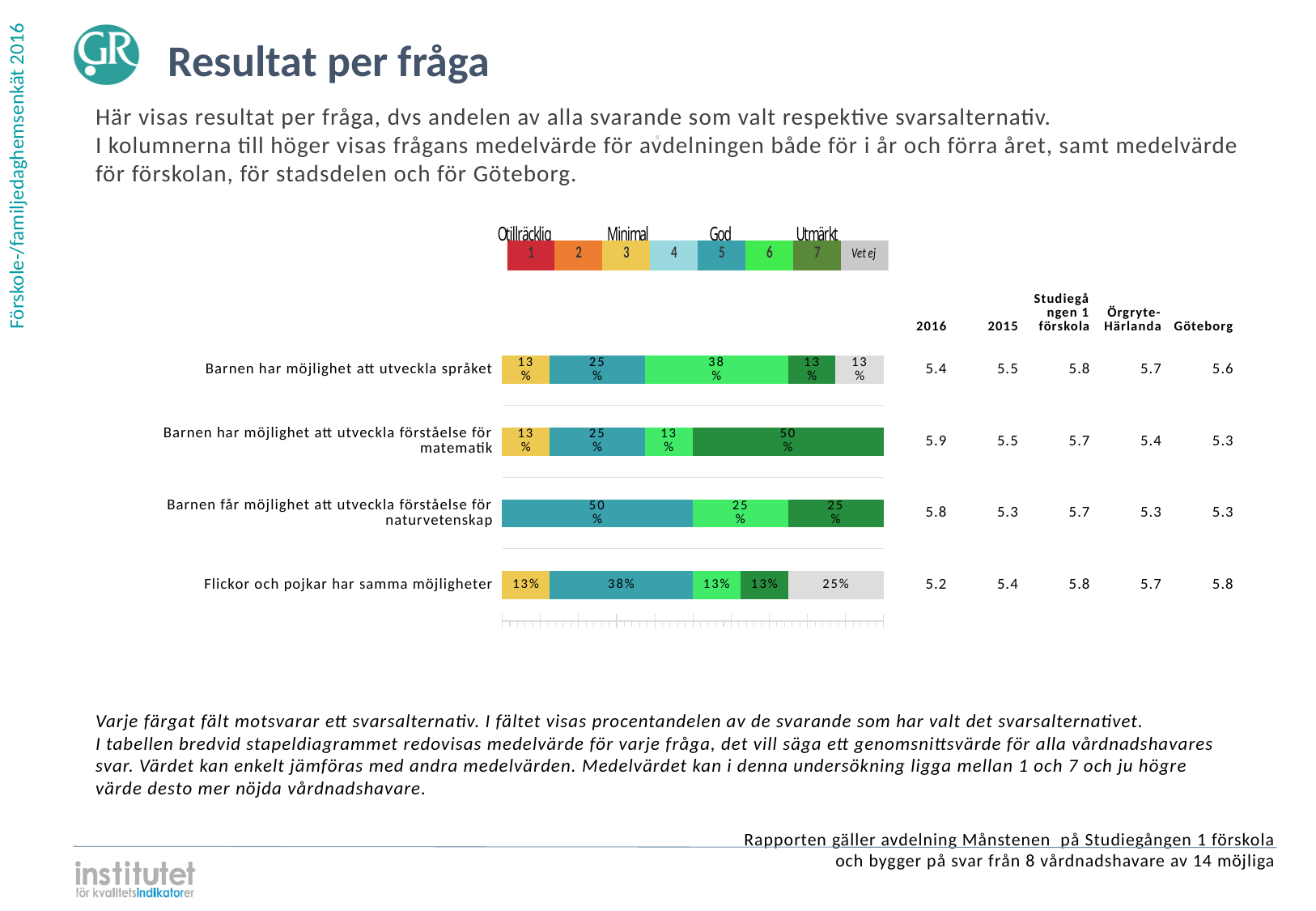
Which is larger for 'Flickor och pojkar har samma möjligheter': the share for option 5 or the share for 'Vet ej'? Option 5 What is the combined share of options 6 and 7 for 'Barnen får möjlighet att utveckla förståelse för naturvetenskap'? 50% How many response options does the legend above the chart list? 8 What label does the legend give to response option 7? Utmärkt What percentage of respondents chose option 7 for 'Barnen har möjlighet att utveckla förståelse för matematik'? 50% What percentage of respondents answered 'Vet ej' for 'Flickor och pojkar har samma möjligheter'? 25% What kind of chart is shown on the slide? Stacked bar chart What is the difference between the option 7 share for 'Barnen har möjlighet att utveckla förståelse för matematik' and the option 7 share for 'Barnen har möjlighet att utveckla språket'? 37 percentage points What percentage of respondents chose option 5 for 'Barnen får möjlighet att utveckla förståelse för naturvetenskap'? 50% How many questions (categories) are plotted in the bar chart? 4 Which response option has the largest share for 'Barnen har möjlighet att utveckla förståelse för matematik'? 7 What percentage of respondents chose option 6 for 'Barnen har möjlighet att utveckla språket'? 38%